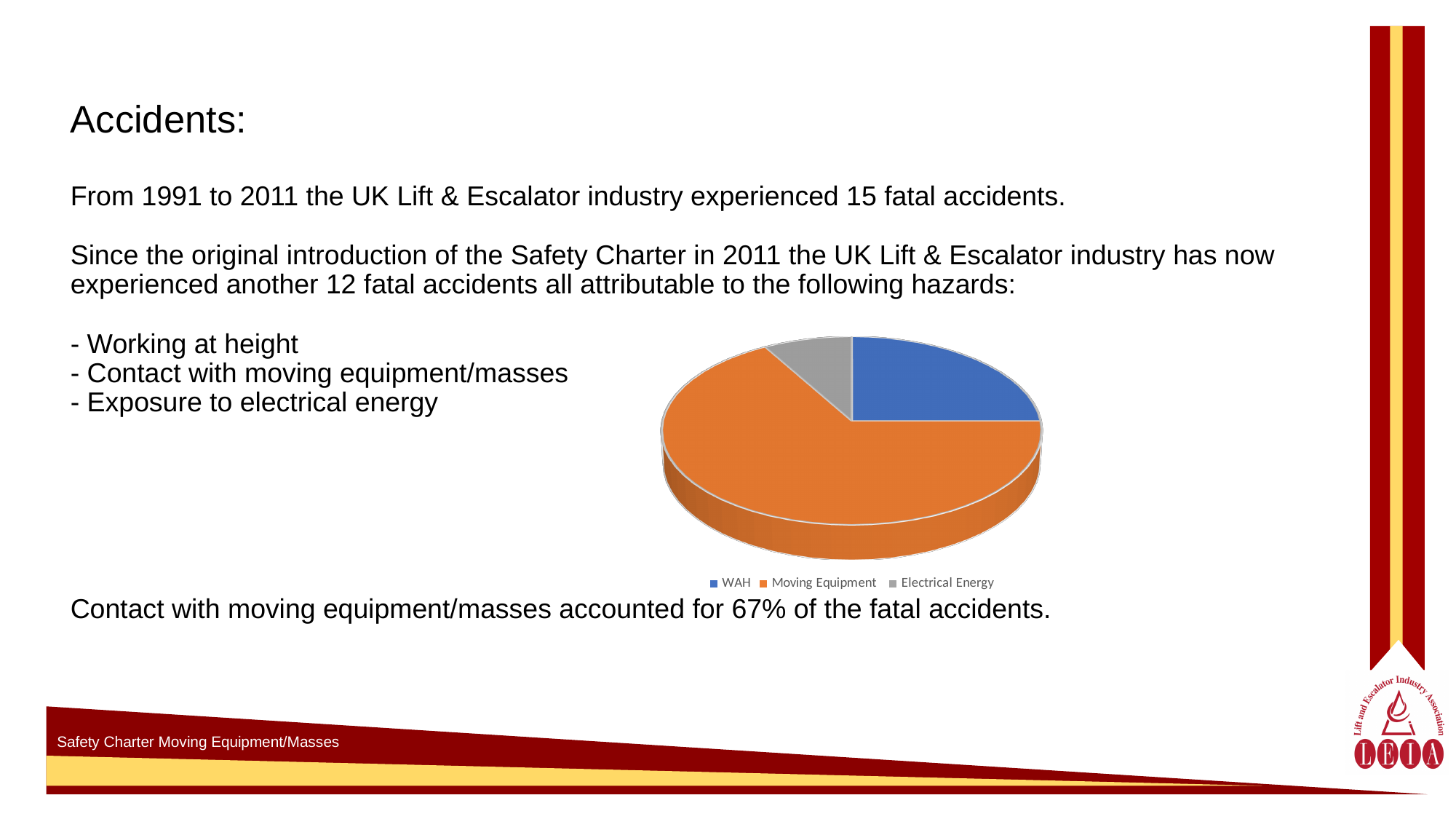
Which slice is larger in the pie chart, Moving Equipment or WAH? Moving Equipment What colour is the WAH slice in the pie chart? Blue Is the Moving Equipment slice more or less than half of the pie chart? More Which category has the largest slice of the pie chart? Moving Equipment How many entries does the pie chart's legend list? 3 Which category has the smallest slice of the pie chart? Electrical Energy According to the slide, what share of the fatal accidents does the Moving Equipment slice represent? 67% Which slice is larger in the pie chart, WAH or Electrical Energy? WAH How many slices does the pie chart have? 3 Which legend entry is shown in grey in the pie chart? Electrical Energy What kind of chart is shown on the slide? Pie chart